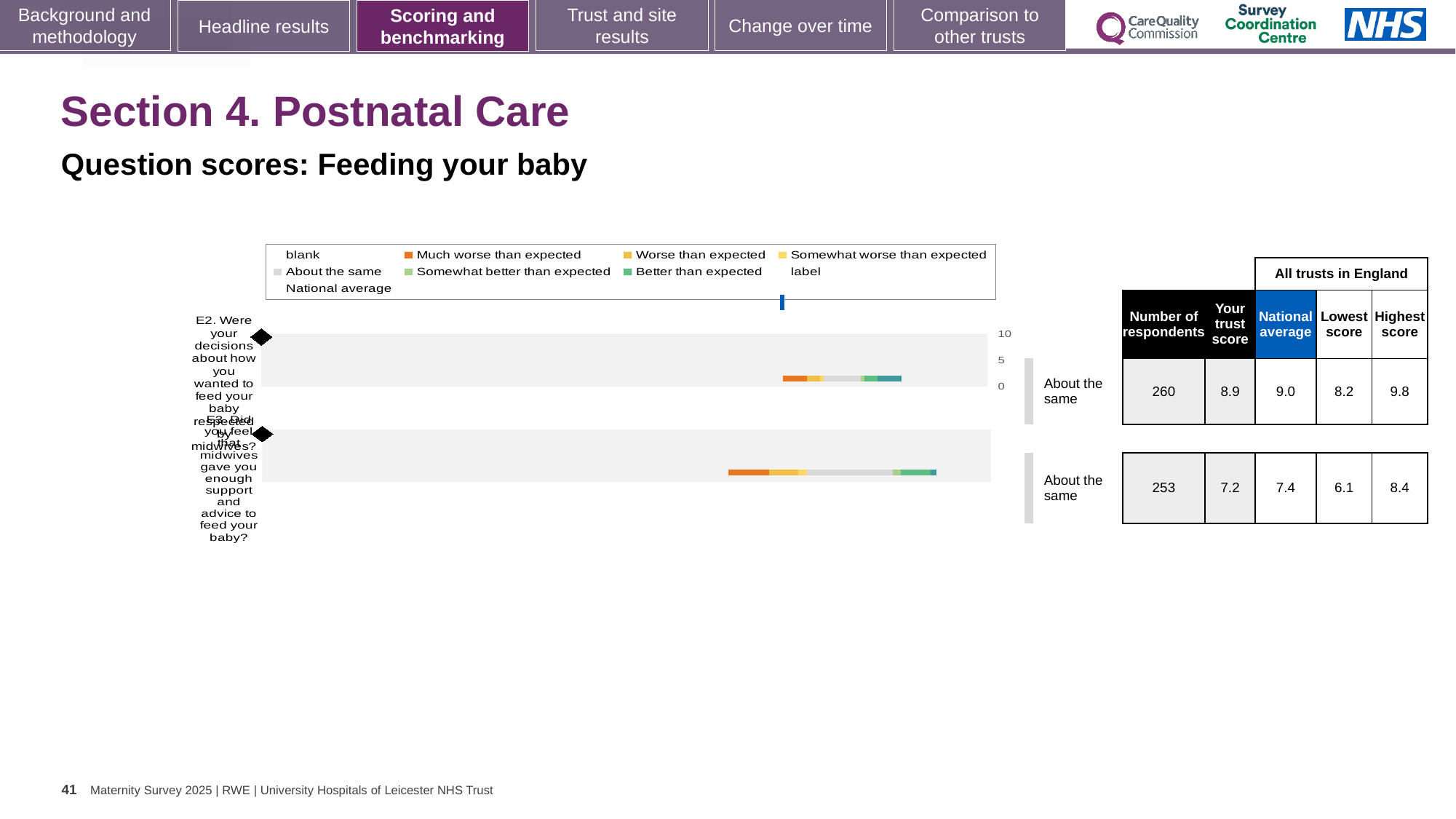
In the table beside the chart, what is the number of respondents for question E2? 260 What is the difference between the highest score and the lowest score for question E2? 1.6 What kind of chart is used to show the question scores for Feeding your baby? bar chart In the chart legend, what colour represents 'Much worse than expected'? orange In the table beside the chart, what is the trust score for question E2? 8.9 What is the difference between the national average and the trust score for question E3? 0.2 What benchmark category is shown next to the bar for question E3? About the same How many questions (categories) are plotted in the Feeding your baby chart? 2 How many entries does the legend of the Feeding your baby chart list? 9 In the table beside the chart, what is the national average for question E3? 7.4 Which question has the higher trust score, E2 or E3? E2 In the table beside the chart, what is the highest score for question E3? 8.4